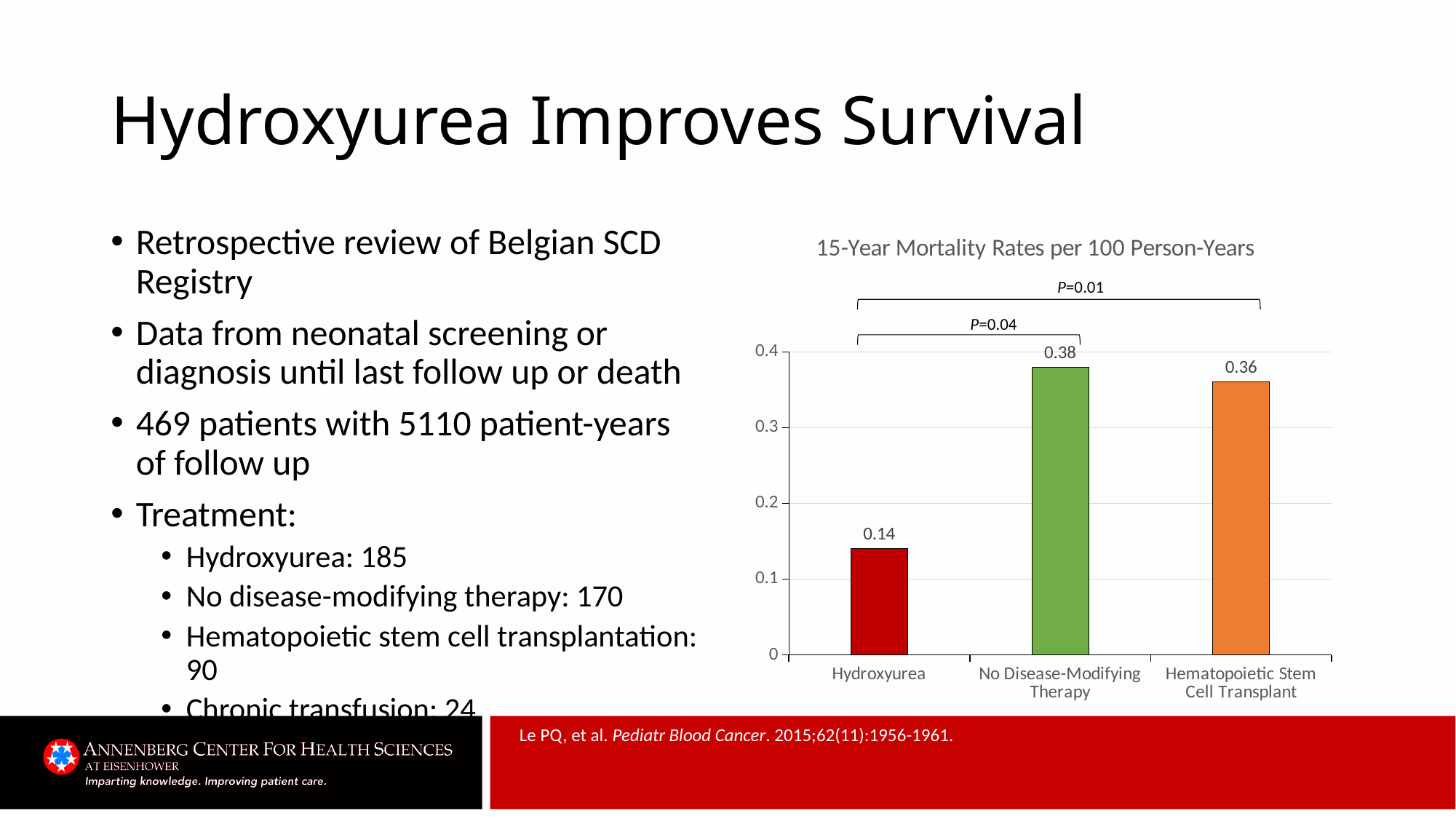
Is the mortality rate for Hydroxyurea greater or less than 0.2? less How many treatment groups are shown in the chart? 3 What is the difference in mortality rate between Hematopoietic Stem Cell Transplant and Hydroxyurea? 0.22 Which has a higher mortality rate, Hydroxyurea or Hematopoietic Stem Cell Transplant? Hematopoietic Stem Cell Transplant What is the difference in mortality rate between No Disease-Modifying Therapy and Hydroxyurea? 0.24 What is the title of the chart? 15-Year Mortality Rates per 100 Person-Years What type of chart is shown on the slide? Bar chart What is the 15-year mortality rate per 100 person-years for No Disease-Modifying Therapy? 0.38 What is the 15-year mortality rate per 100 person-years for Hematopoietic Stem Cell Transplant? 0.36 What is the 15-year mortality rate per 100 person-years for Hydroxyurea? 0.14 Which treatment group has the highest 15-year mortality rate? No Disease-Modifying Therapy Which treatment group has the lowest 15-year mortality rate? Hydroxyurea